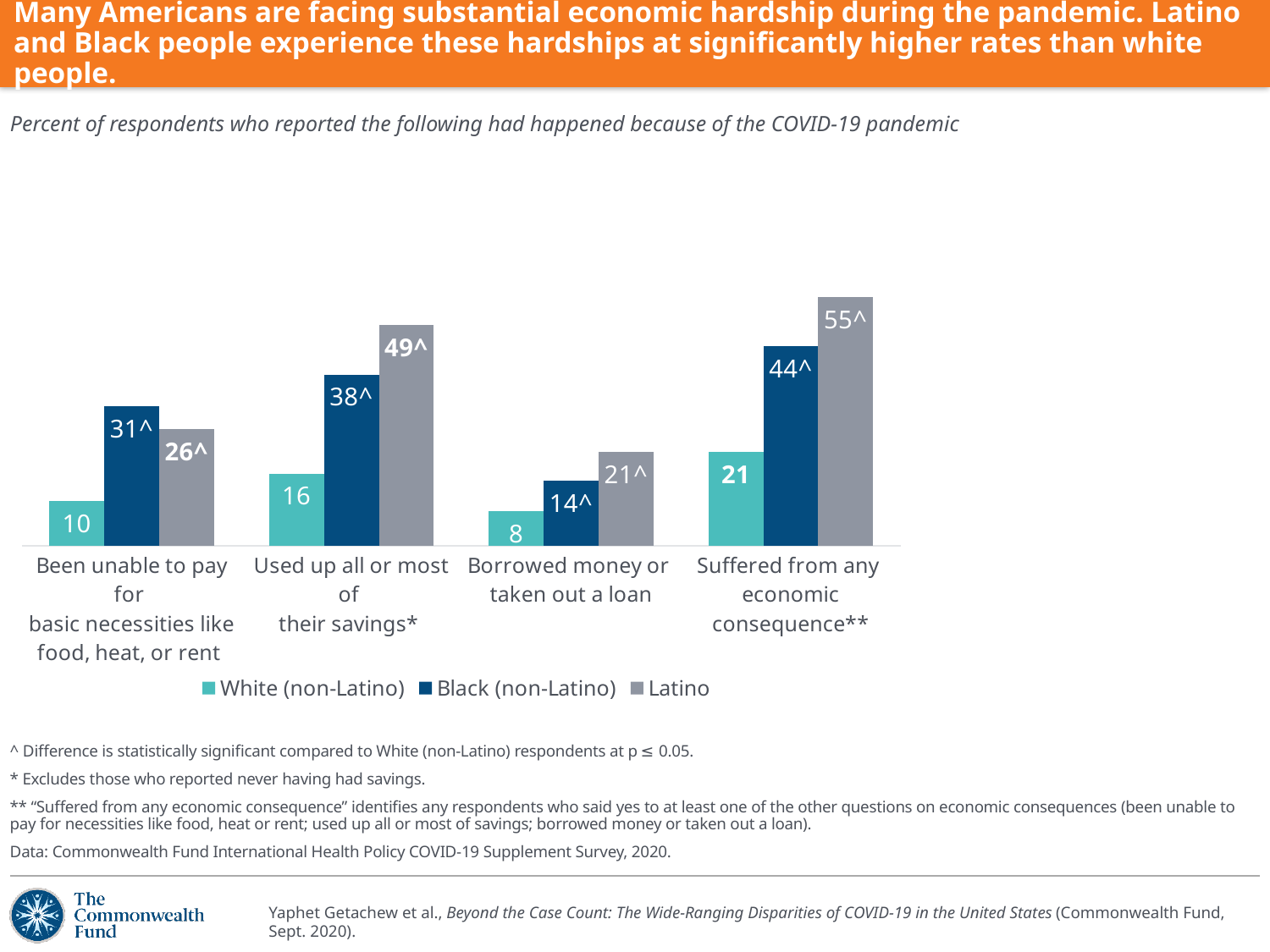
How many categories are shown on the x axis of the chart? 4 Which group has the highest value for 'Borrowed money or taken out a loan'? Latino What is the difference between the Black (non-Latino) and Latino values for 'Been unable to pay for basic necessities like food, heat, or rent'? 5 What kind of chart is shown on the slide? Bar chart What percentage of White (non-Latino) respondents reported being unable to pay for basic necessities like food, heat, or rent? 10 For 'Been unable to pay for basic necessities', which is larger: the Black (non-Latino) value or the Latino value? Black (non-Latino) What value is shown for Latino respondents who used up all or most of their savings? 49^ What is the difference between the Latino and White (non-Latino) values for 'Suffered from any economic consequence'? 34 Which category has the lowest value for White (non-Latino) respondents? Borrowed money or taken out a loan Which series is shown in the dark blue colour in the legend? Black (non-Latino) How many series does the legend list? 3 What value is shown for Black (non-Latino) respondents who suffered from any economic consequence? 44^